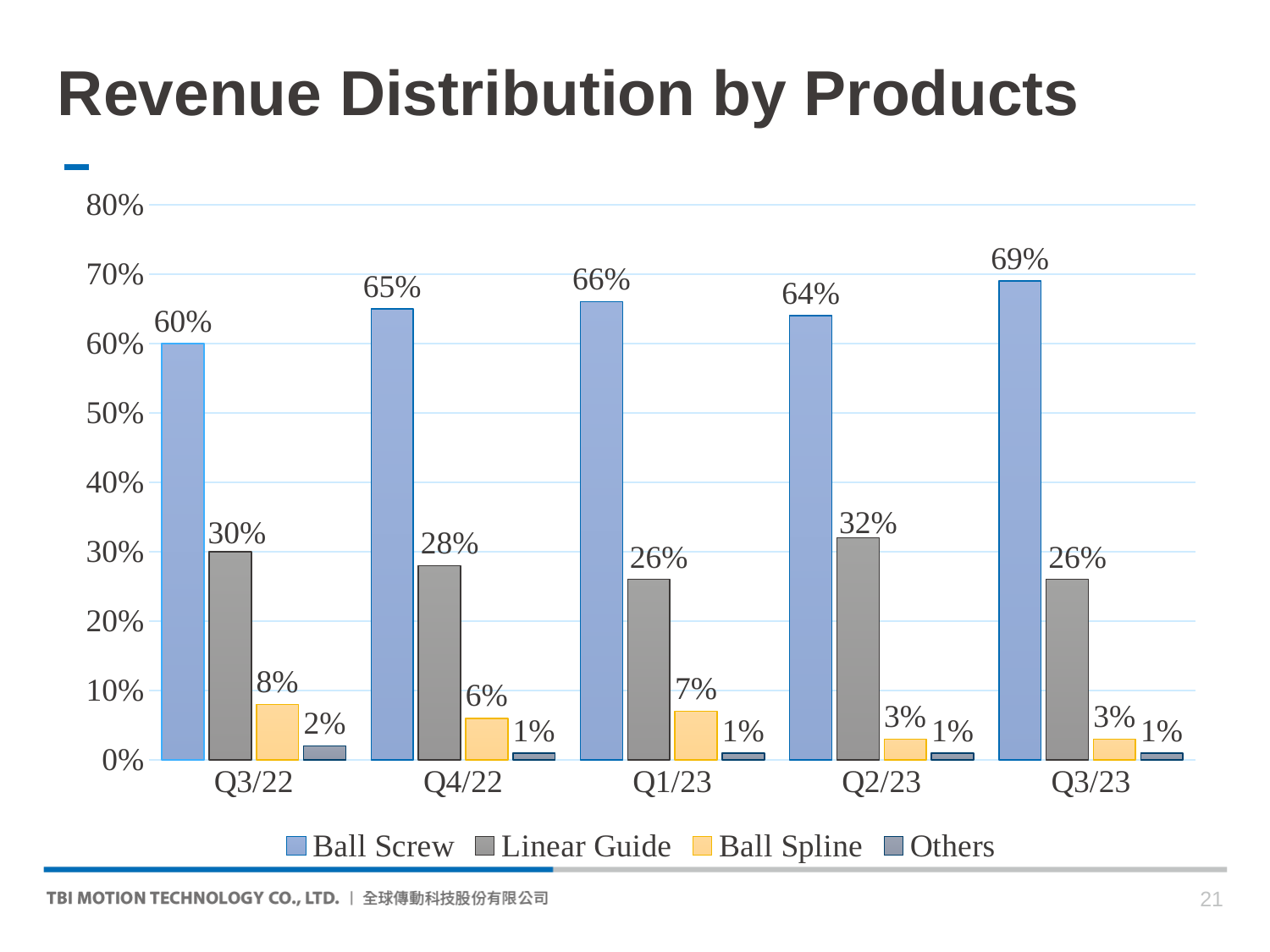
In which quarter is the Ball Spline share lowest? Q2/23 and Q3/23 What is the Ball Screw share of revenue in Q3/23? 69% Which is larger, the Linear Guide share in Q2/23 or in Q1/23? Q2/23 How many series does the legend list? 4 What is the title of the chart? Revenue Distribution by Products In which quarter is the Ball Screw share highest? Q3/23 What kind of chart is shown on the slide? Bar chart What is the Linear Guide share of revenue in Q2/23? 32% Is the Ball Screw share in Q4/22 greater or less than 60%? greater What is the Ball Spline share of revenue in Q3/22? 8% How many quarters are shown on the x axis? 5 What is the difference between the Ball Screw share in Q3/23 and in Q3/22? 9%